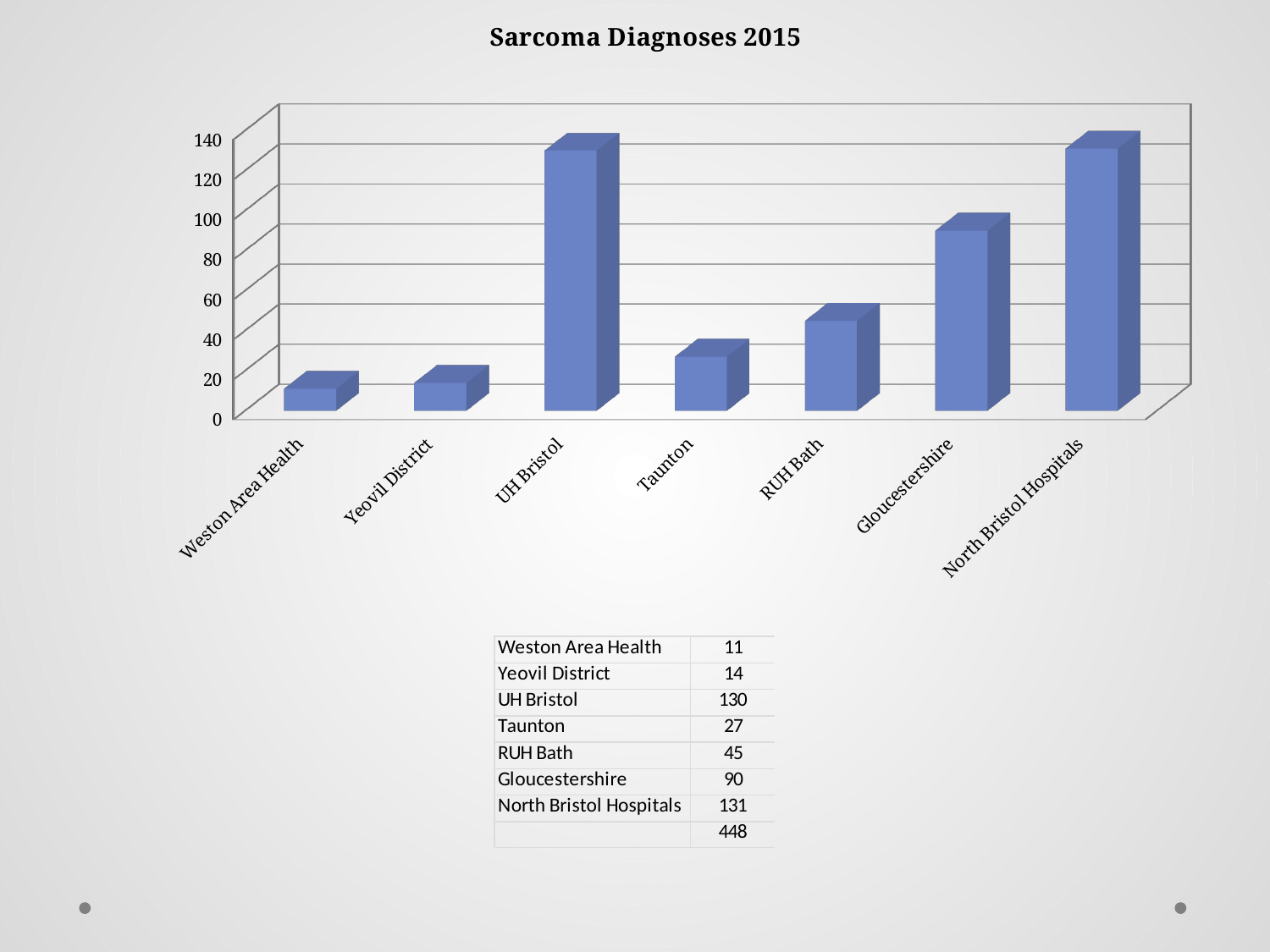
How many sarcoma diagnoses are shown for Gloucestershire? 90 Which category has the highest value in the chart? North Bristol Hospitals What kind of chart is shown on the slide? bar chart Which is larger, the value for Taunton or the value for Yeovil District? Taunton What is the value for Taunton? 27 Is the value for Gloucestershire greater or less than 100? less What is the value for UH Bristol in the Sarcoma Diagnoses 2015 chart? 130 What is the title of the chart? Sarcoma Diagnoses 2015 How many categories are shown on the x axis of the chart? 7 Which category has the lowest value in the chart? Weston Area Health What is the difference between the values for Gloucestershire and RUH Bath? 45 What is the value for RUH Bath? 45